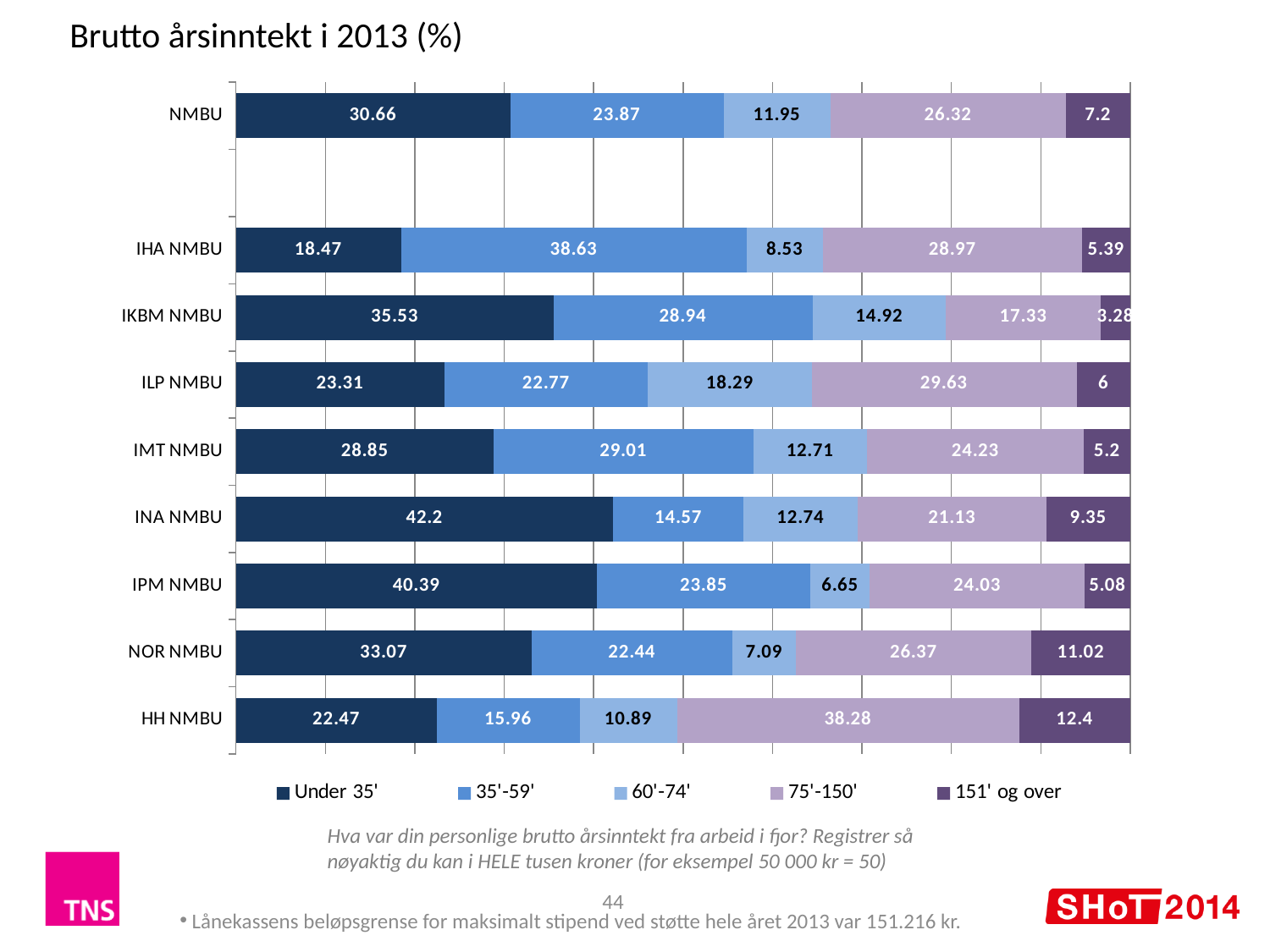
Which has the larger "35'-59'" value, IHA NMBU or IKBM NMBU? IHA NMBU How many series does the legend list? 5 What is the value of the "151' og over" series for HH NMBU? 12.4 How many categories are shown on the y axis of the chart? 9 What is the value of the "Under 35'" series for INA NMBU? 42.2 Which category has the highest value in the "Under 35'" series? INA NMBU What kind of chart is shown on the slide? Stacked bar chart What is the total of the stacked bar for NMBU? 100 For NMBU, what is the difference between the "Under 35'" value and the "35'-59'" value? 6.79 What is the value of the "75'-150'" series for IKBM NMBU? 17.33 Which category has the highest value in the "75'-150'" series? HH NMBU Which category has the lowest value in the "60'-74'" series? IPM NMBU